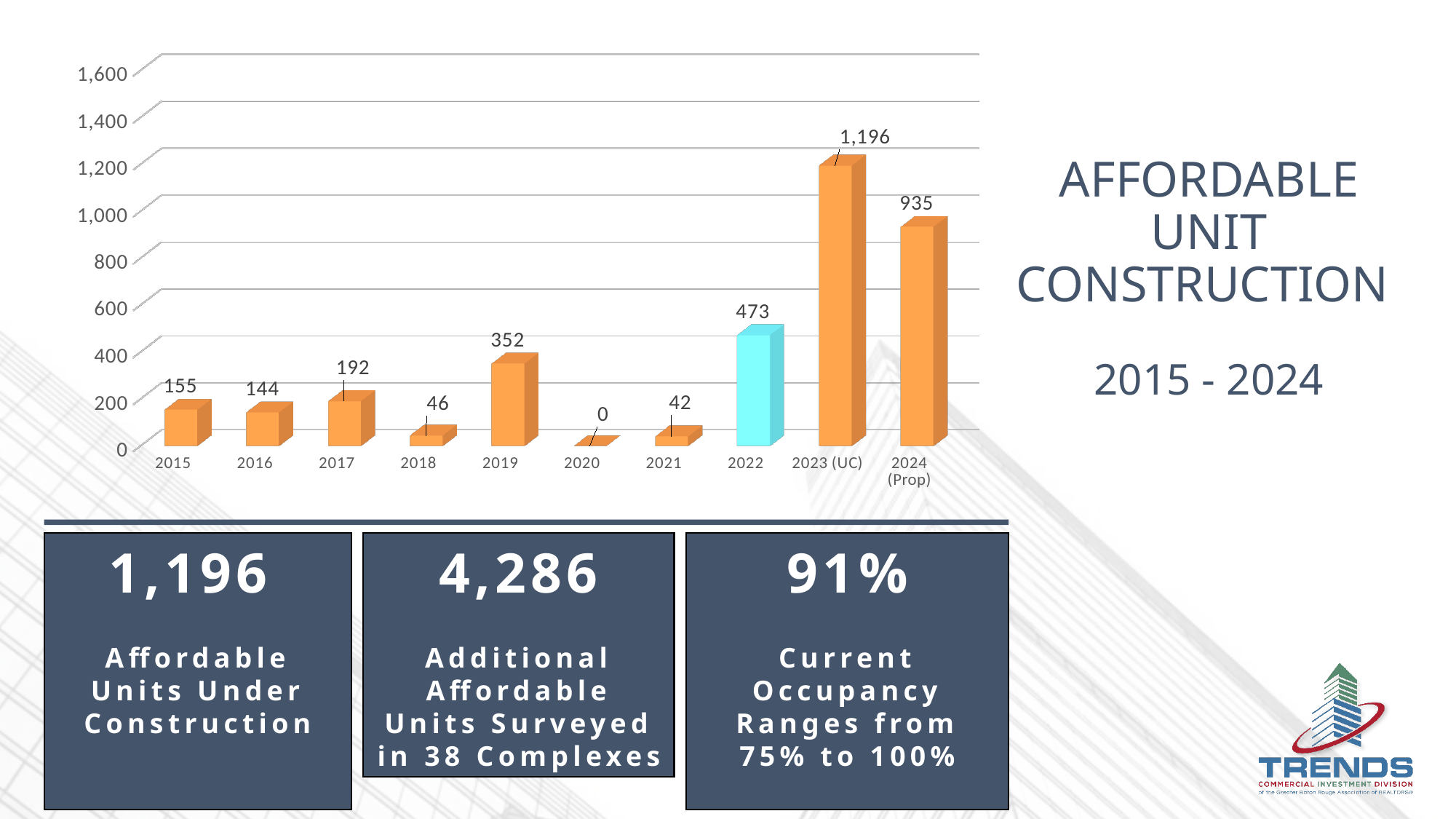
What is the value for 2022? 473 Which year has the lowest value? 2020 Do the values rise or fall from 2021 to 2023 (UC)? rise Which year has the highest value? 2023 (UC) How many categories are shown on the x axis? 10 What is the value for 2024 (Prop)? 935 What is the value for 2019? 352 What kind of chart is shown? bar chart Is the value for 2022 greater or less than 400? greater Which is larger, the value for 2015 or the value for 2016? 2015 What is the difference between the values for 2023 (UC) and 2024 (Prop)? 261 Which bar is shown in a different colour (blue) from the others? 2022